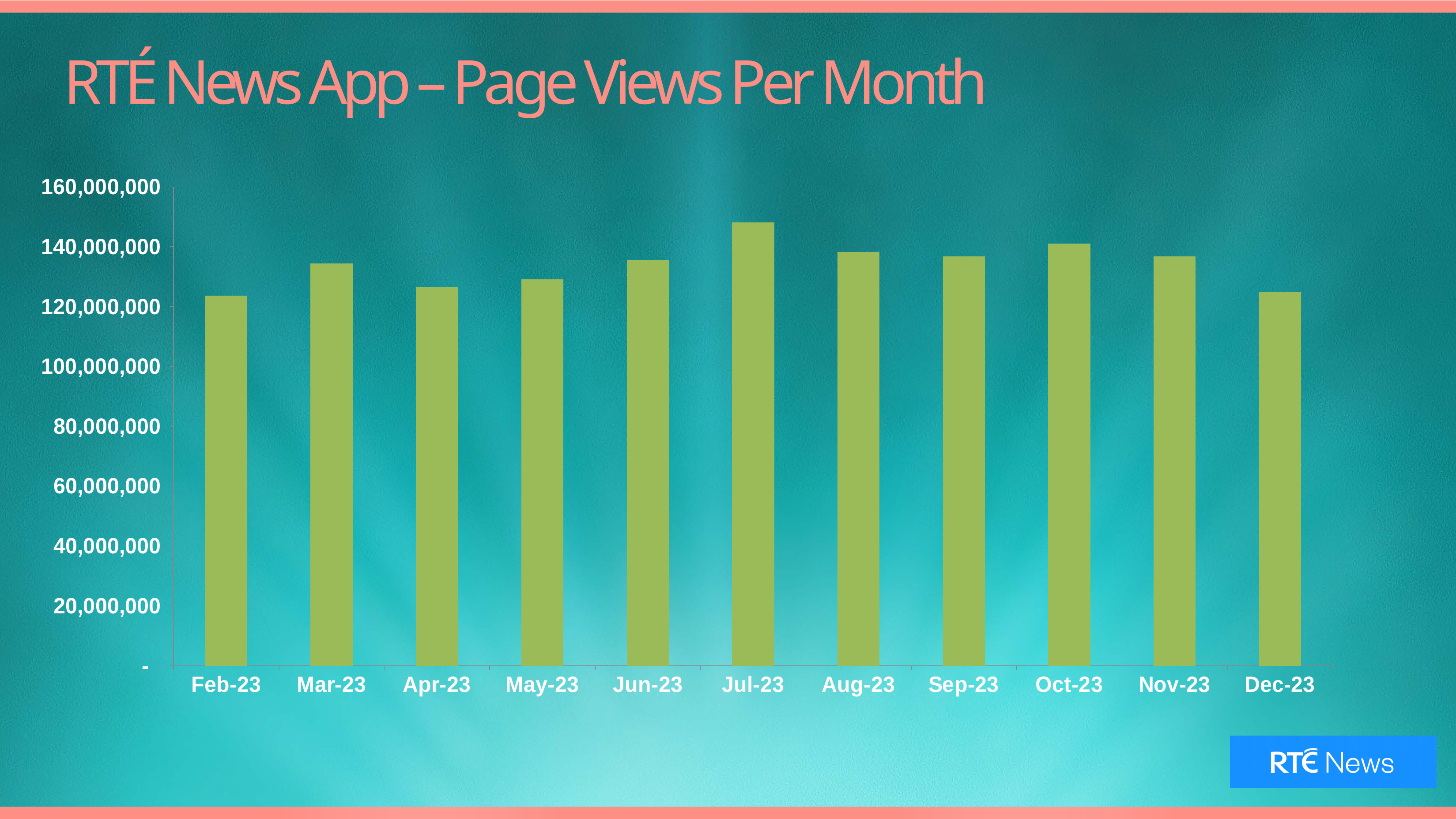
From Oct-23 to Dec-23, do the values rise or fall? fall Is the value for Jul-23 greater or less than 140,000,000? greater Is the value for Mar-23 greater or less than 140,000,000? less Is the value for Apr-23 greater or less than 120,000,000? greater What is the title of the chart? RTÉ News App – Page Views Per Month Which is larger, the value for Jul-23 or the value for Feb-23? Jul-23 What kind of chart is shown on the slide? bar chart Which is larger, the value for Mar-23 or the value for Apr-23? Mar-23 How many months are plotted on the chart? 11 Which month has the highest page views? Jul-23 Which is larger, the value for Oct-23 or the value for Dec-23? Oct-23